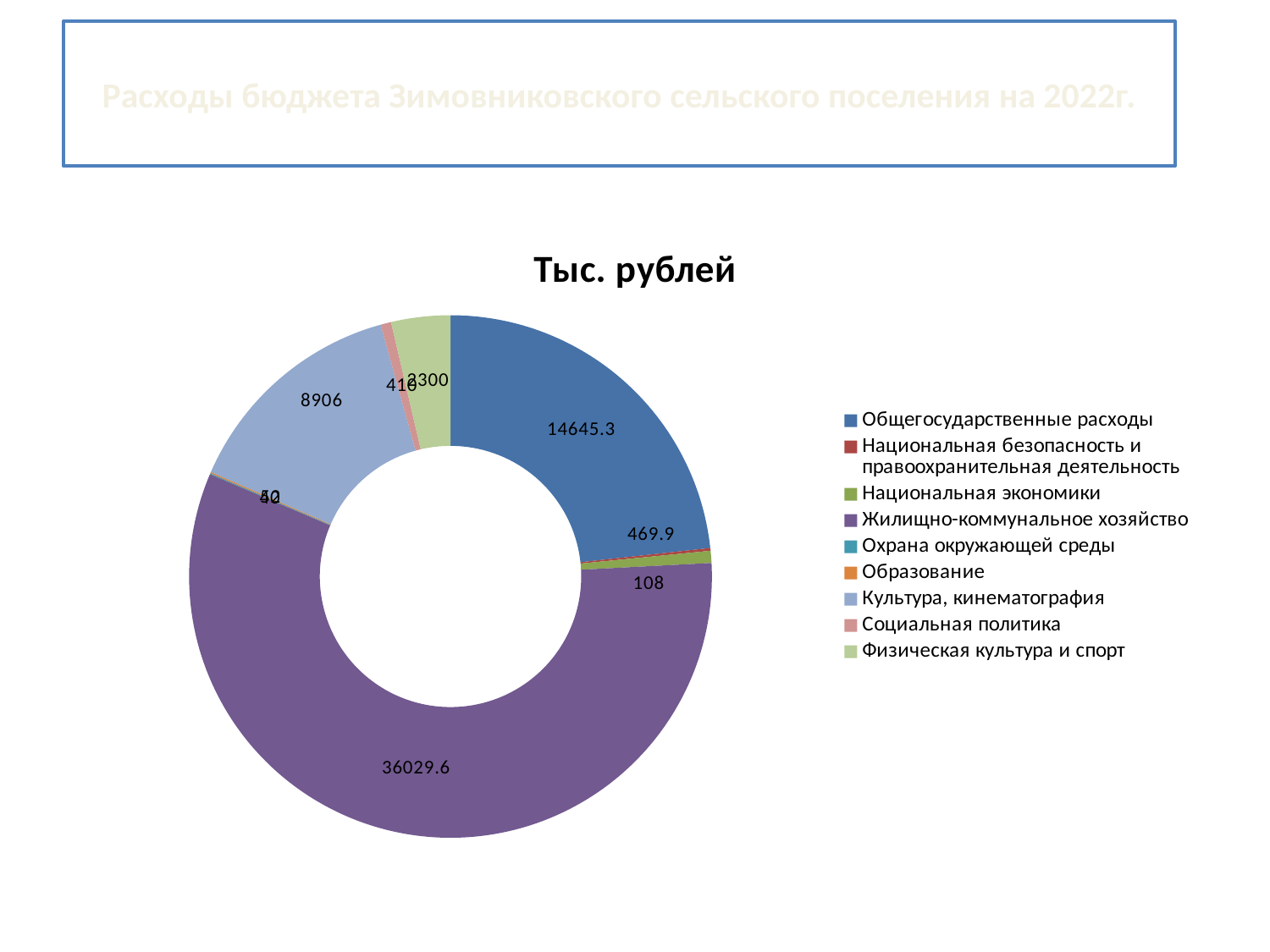
What is the value for Культура, кинематография? 8906 How many categories does the chart's legend list? 9 What kind of chart is shown on the slide? doughnut (pie) chart What is the title of the chart? Тыс. рублей Which category has the largest value? Жилищно-коммунальное хозяйство Which is larger: Общегосударственные расходы or Культура, кинематография? Общегосударственные расходы What is the value for Жилищно-коммунальное хозяйство? 36029.6 What is the difference between the values for Жилищно-коммунальное хозяйство and Общегосударственные расходы? 21384.3 What is the value for Физическая культура и спорт? 2300 What is the value for Общегосударственные расходы? 14645.3 What is the value for Национальная экономики? 469.9 What is the value for Национальная безопасность и правоохранительная деятельность? 108